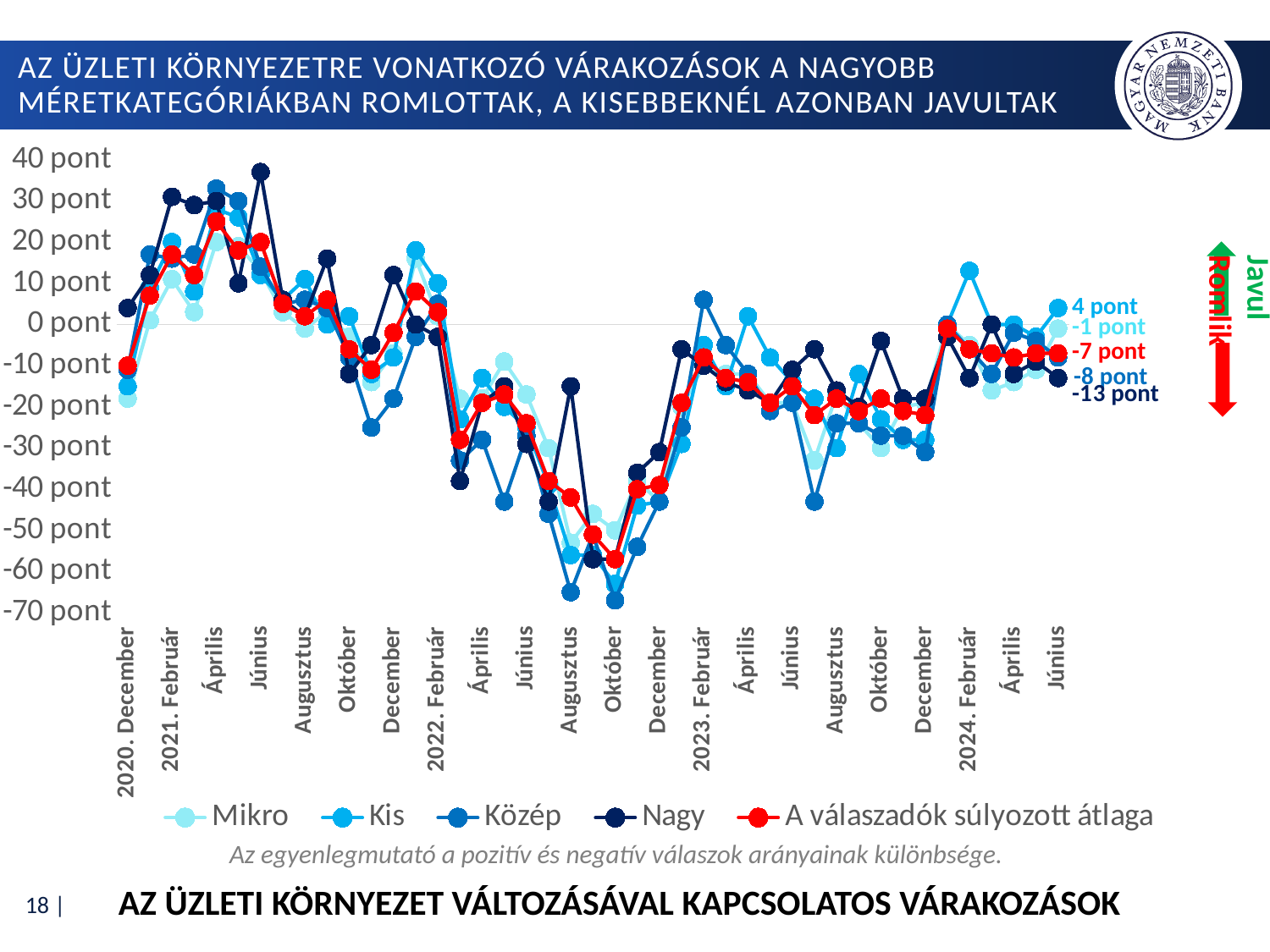
Which series has the highest labelled value at the end of the chart (June 2024)? Kis How many series does the legend list? 5 What type of chart is shown on the slide? line chart What is the latest (June 2024) value labelled for the Kis series? 4 pont Which series has the lowest labelled value at the end of the chart (June 2024)? Nagy Does the weighted average ('A válaszadók súlyozott átlaga') rise or fall between 2022. Február and 2022. Október? fall At the end of the chart, is the labelled value for Közép larger or smaller than that for 'A válaszadók súlyozott átlaga'? smaller Is the value for the Kis series in 2022 Október greater or less than -60 pont? less What is the latest value labelled for the Nagy series? -13 pont What is the latest value labelled for the Mikro series? -1 pont What is the latest value labelled for 'A válaszadók súlyozott átlaga'? -7 pont What is the difference between the end-of-chart labelled values of Kis (4 pont) and Nagy (-13 pont)? 17 pont